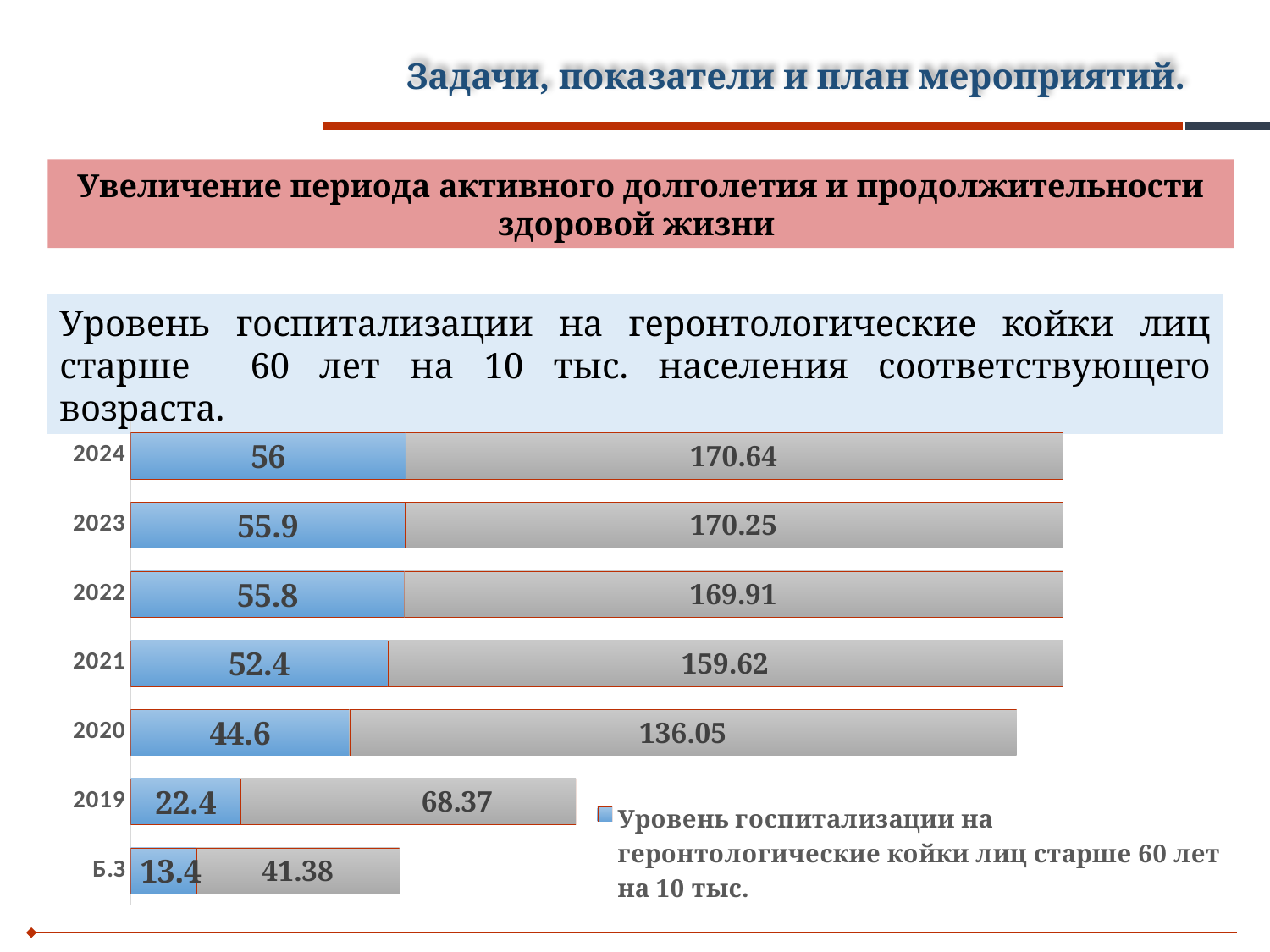
What kind of chart is shown on the slide? Bar chart How many categories are shown on the chart? 7 Which category has the highest blue segment value? 2024 What is the value of the grey segment for Б.З? 41.38 Which category has the lowest grey segment value? Б.З What is the difference between the grey segment values for 2020 and 2019? 67.68 What is the total of the stacked bar for 2019? 90.77 What is the value of the blue segment for 2024? 56 Which is larger, the blue segment value for 2021 or for 2020? 2021 Do the blue segment values rise or fall going from Б.З up to 2024? Rise What is the value of the grey segment for 2021? 159.62 How many series does the legend list? 1